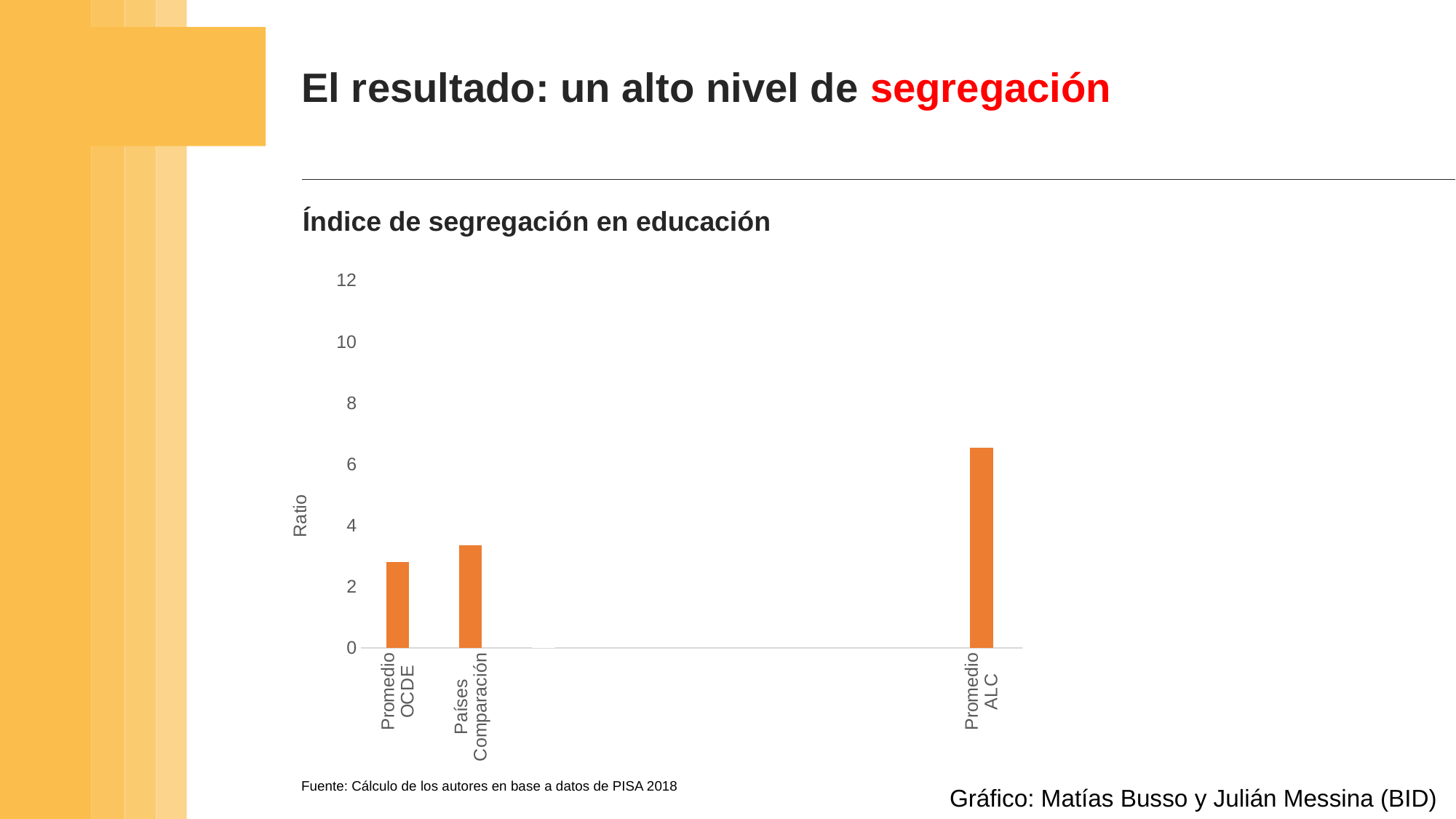
Which category has the highest value in the chart? Promedio ALC Which category has the lowest value in the chart? Promedio OCDE What kind of chart is shown on the slide? bar chart Which is larger, the value for Promedio ALC or the value for Países Comparación? Promedio ALC Which is larger, the value for Países Comparación or the value for Promedio OCDE? Países Comparación Do the bar values rise or fall from left to right across the chart? rise What is the label on the vertical axis of the chart? Ratio Is the value for Promedio ALC greater or less than 6? greater Is the value for Países Comparación greater or less than 4? less How many labeled categories (bars) are plotted in the chart? 3 What is the title of the chart? Índice de segregación en educación Is the value for Promedio OCDE greater or less than 4? less